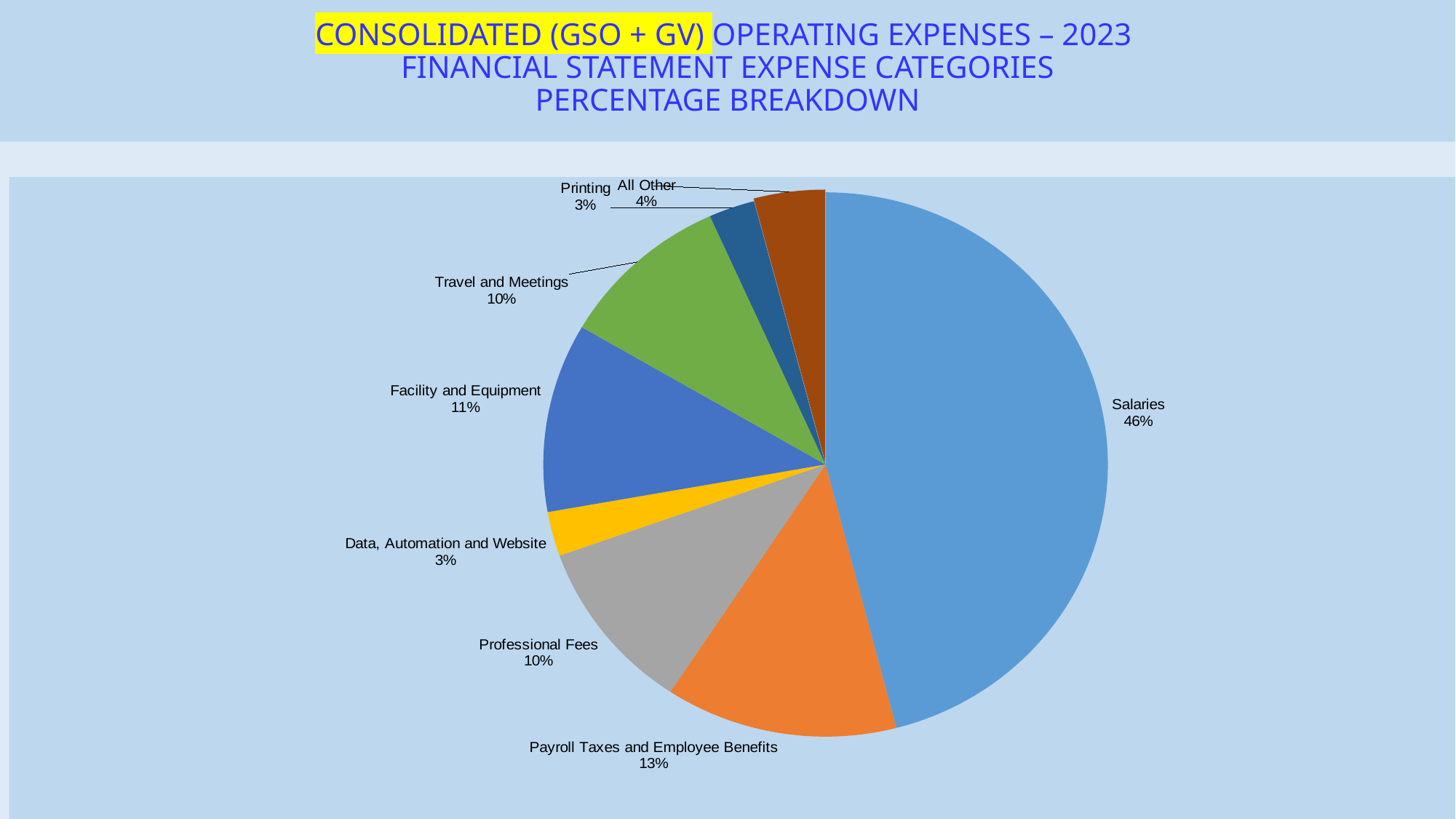
What is the combined percentage of Printing and Data, Automation and Website? 6% What percentage is shown for Travel and Meetings? 10% Which is larger, Facility and Equipment or Professional Fees? Facility and Equipment What percentage is shown for All Other? 4% What is the difference in percentage points between Salaries and Payroll Taxes and Employee Benefits? 33 What kind of chart is shown on the slide? Pie chart How many slices does the pie chart have? 8 What percentage of operating expenses is Salaries? 46% Which expense category has the largest share of the pie? Salaries What share of the pie is Payroll Taxes and Employee Benefits? 13% Which year does the chart title say the operating expenses are for? 2023 What percentage is shown for Facility and Equipment? 11%